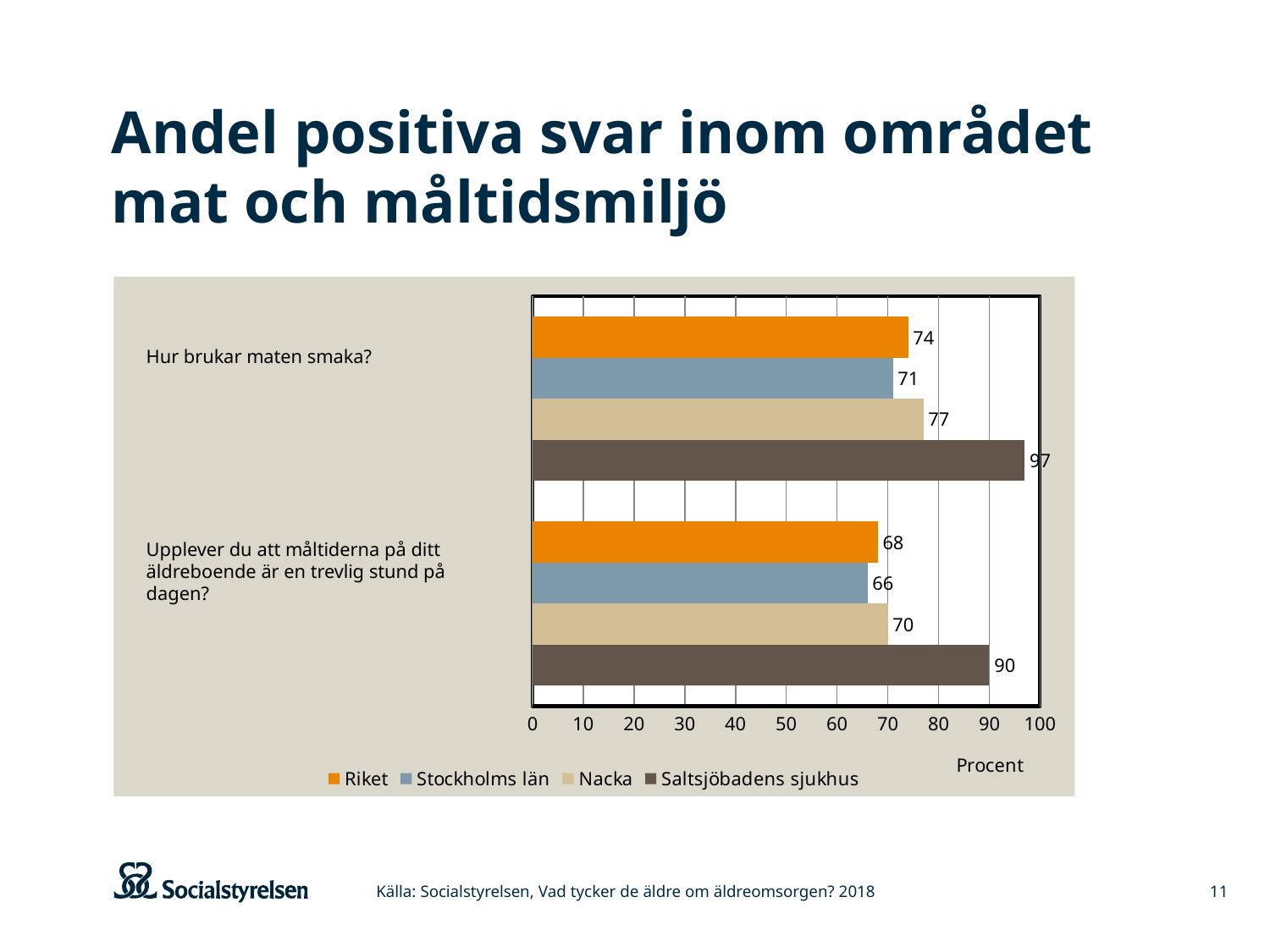
Which series has the highest value for "Hur brukar maten smaka?"? Saltsjöbadens sjukhus How many series does the legend list? 4 What is the difference between Saltsjöbadens sjukhus and Riket for "Hur brukar maten smaka?"? 23 What is the value for Saltsjöbadens sjukhus for the question "Hur brukar maten smaka?"? 97 What kind of chart is shown on the slide? Bar chart What is the difference between Nacka and Stockholms län for "Upplever du att måltiderna på ditt äldreboende är en trevlig stund på dagen?"? 4 What is the value for Riket for the question "Upplever du att måltiderna på ditt äldreboende är en trevlig stund på dagen?"? 68 Which series has the lowest value for "Upplever du att måltiderna på ditt äldreboende är en trevlig stund på dagen?"? Stockholms län What is the value for Nacka for the question "Hur brukar maten smaka?"? 77 What is the label of the x axis? Procent Which is larger for "Hur brukar maten smaka?": Riket or Nacka? Nacka What is the value for Stockholms län for the question "Upplever du att måltiderna på ditt äldreboende är en trevlig stund på dagen?"? 66